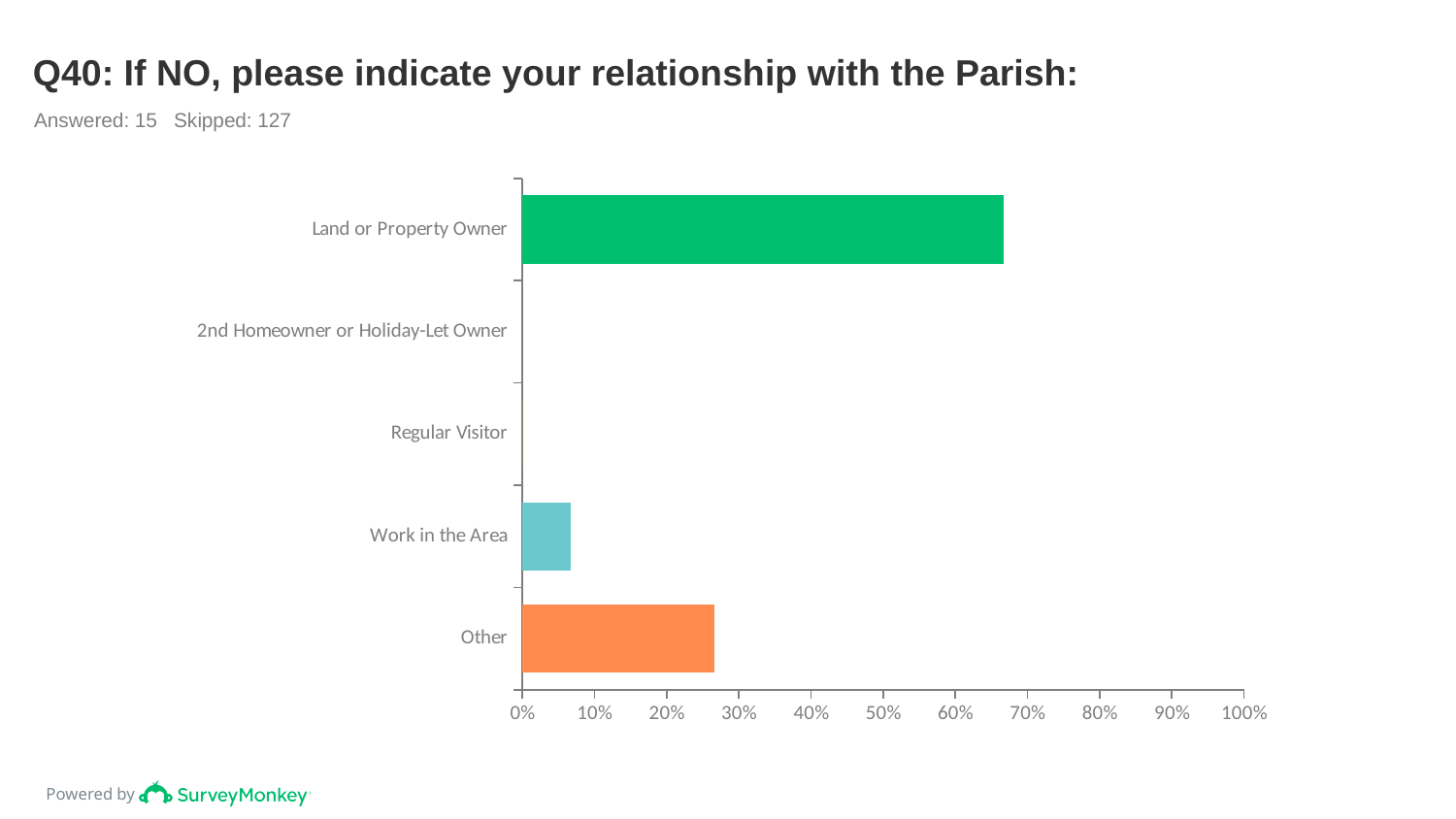
Which category has the highest value? Land or Property Owner How many respondents answered the question according to the slide? 15 Which is larger, the value for Other or the value for Work in the Area? Other What is the title of the chart? Q40: If NO, please indicate your relationship with the Parish: What kind of chart is shown on the slide? bar chart Is the value for Other greater or less than 20%? greater Which is larger, the value for Land or Property Owner or the value for Other? Land or Property Owner How many categories are shown on the chart? 5 Is the value for Land or Property Owner greater or less than 60%? greater Is the value for Work in the Area greater or less than 10%? less